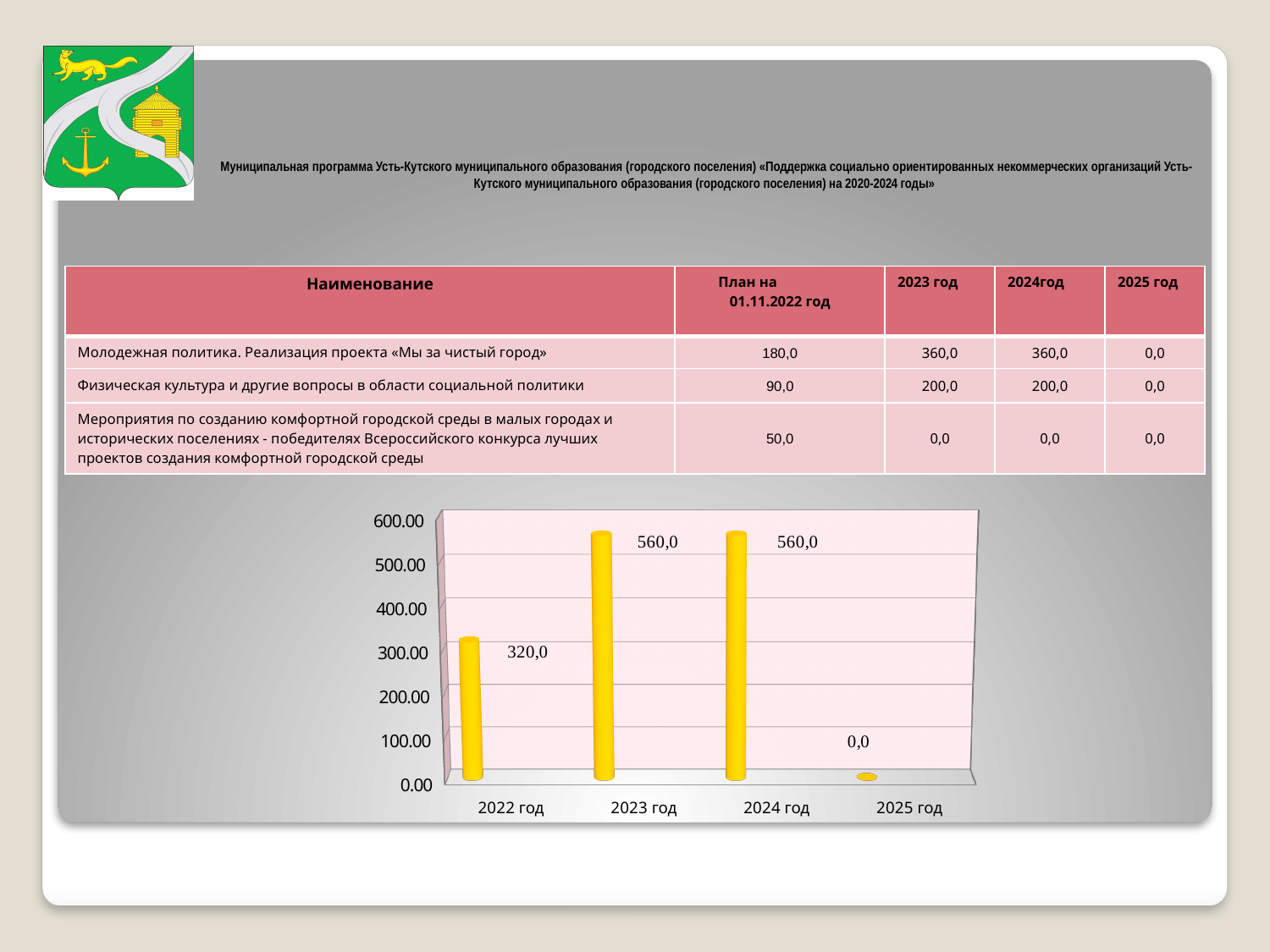
Which category has the lowest value? 2025 год Is the value for 2024 год greater or less than 500.00? greater What kind of chart is shown on the slide? bar chart Is the value for 2022 год greater or less than 400.00? less What is the value for 2025 год? 0,0 What is the value for 2023 год? 560,0 Which is larger, the value for 2022 год or the value for 2024 год? 2024 год What is the value for 2022 год? 320,0 What is the highest tick value shown on the vertical axis? 600.00 What is the difference between the values for 2023 год and 2022 год? 240,0 How many categories are shown on the x axis? 4 Do the values rise or fall from 2024 год to 2025 год? fall